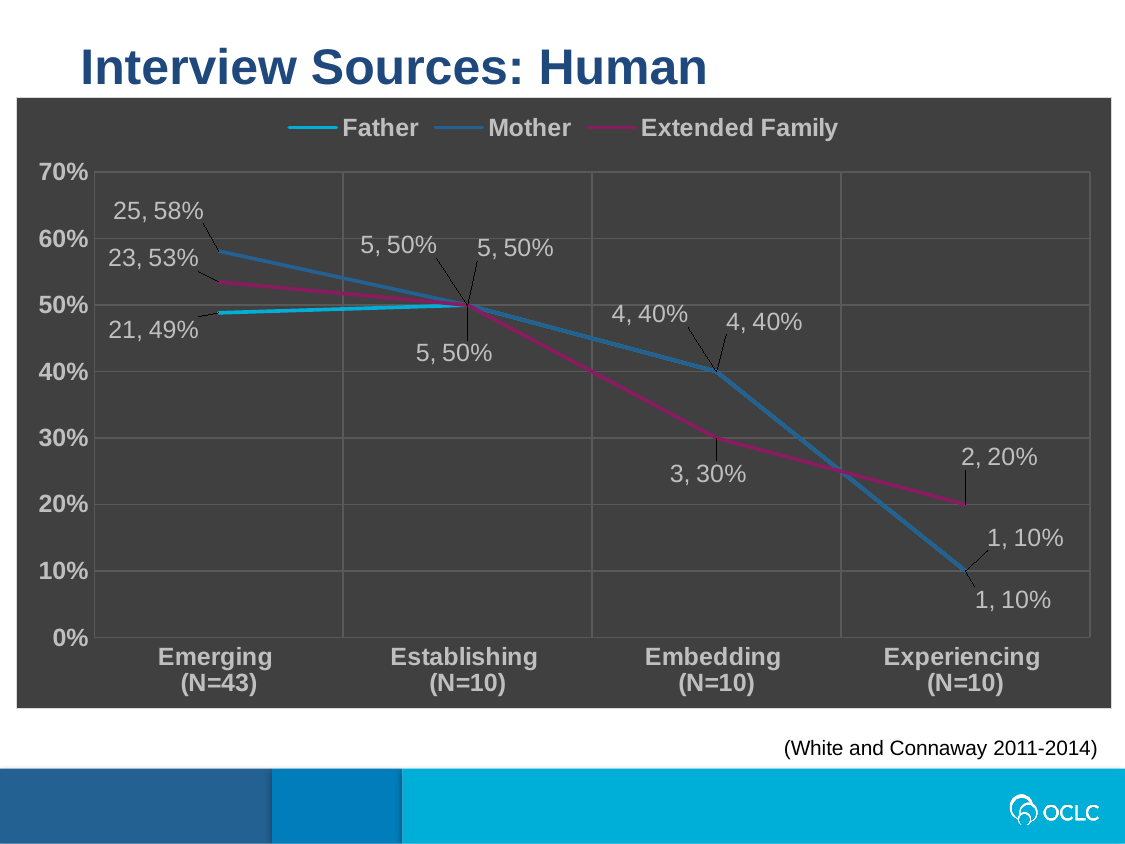
What is the percentage for Father in the Emerging (N=43) category? 49% Which series has the highest value in the Emerging (N=43) category? Mother Which series has the lowest value in the Embedding (N=10) category? Extended Family What is the percentage for Mother in the Emerging (N=43) category? 58% What is the percentage for Extended Family in the Experiencing (N=10) category? 20% What kind of chart is shown on the slide? line chart How many categories are shown on the x axis? 4 What is the percentage for Extended Family in the Embedding (N=10) category? 30% How many series does the legend list? 3 Do the values for Extended Family rise or fall from Emerging to Experiencing? fall In the Experiencing (N=10) category, is the value for Extended Family larger or smaller than the value for Mother? larger What is the difference between the Mother and Father percentages in the Emerging (N=43) category? 9%